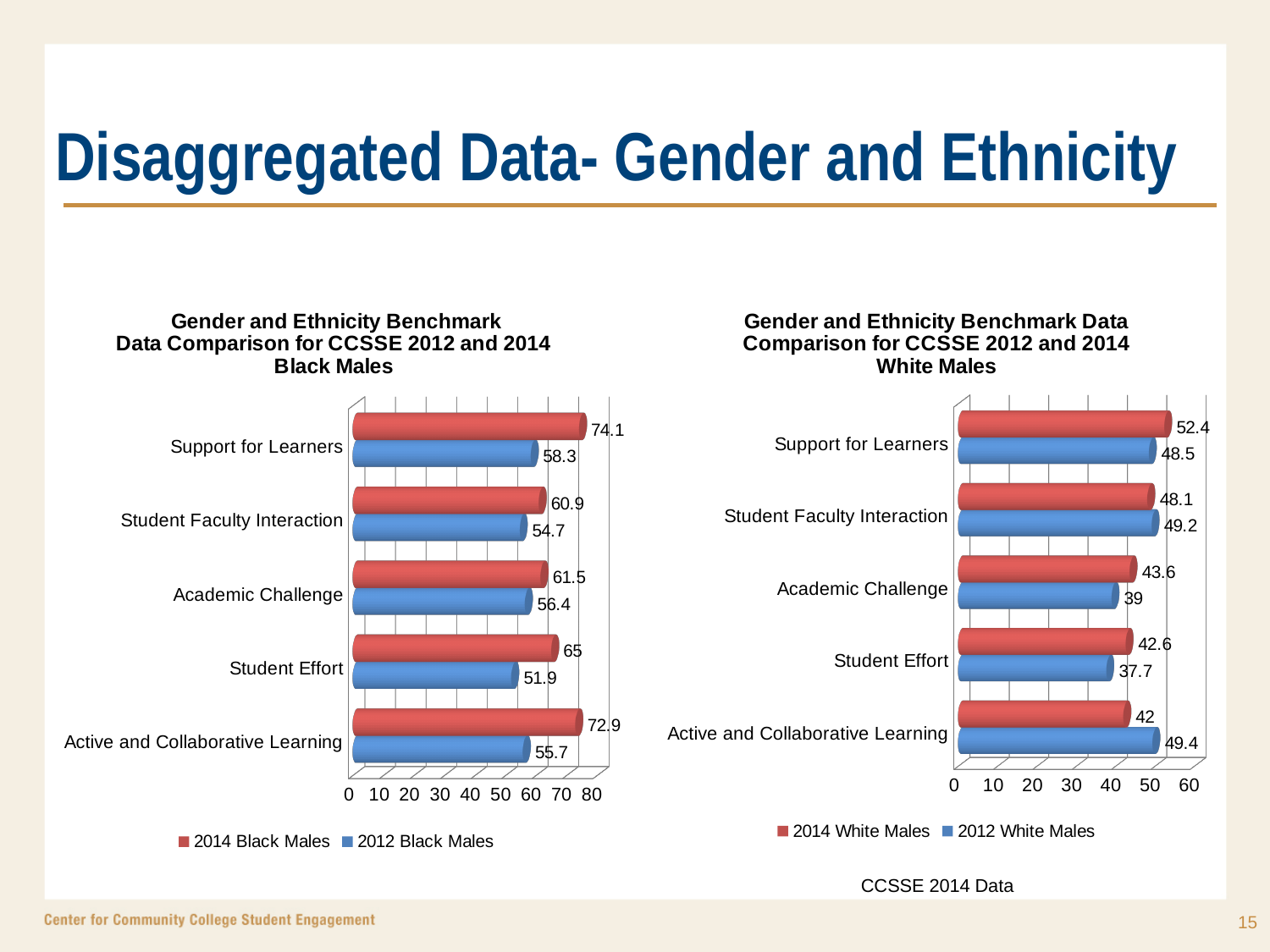
What type of chart is the Black Males chart? Bar chart How many series does the legend of the White Males chart list? 2 In the Black Males chart, which benchmark has the highest value for 2014 Black Males? Support for Learners In the Black Males chart, what is the value for 2012 Black Males on Student Effort? 51.9 In the White Males chart, what is the value for 2014 White Males on Active and Collaborative Learning? 42 In the White Males chart, which benchmark has the lowest value for 2012 White Males? Student Effort In the Black Males chart, what is the difference between the 2014 and 2012 values for Active and Collaborative Learning? 17.2 In the Black Males chart, what is the value for 2014 Black Males on Support for Learners? 74.1 In the White Males chart, what is the value for 2012 White Males on Academic Challenge? 39 In the White Males chart, which is larger for Student Faculty Interaction: the 2014 value or the 2012 value? 2012 White Males How many benchmark categories are shown in the Black Males chart? 5 In the White Males chart, what is the difference between the 2012 and 2014 values for Active and Collaborative Learning? 7.4